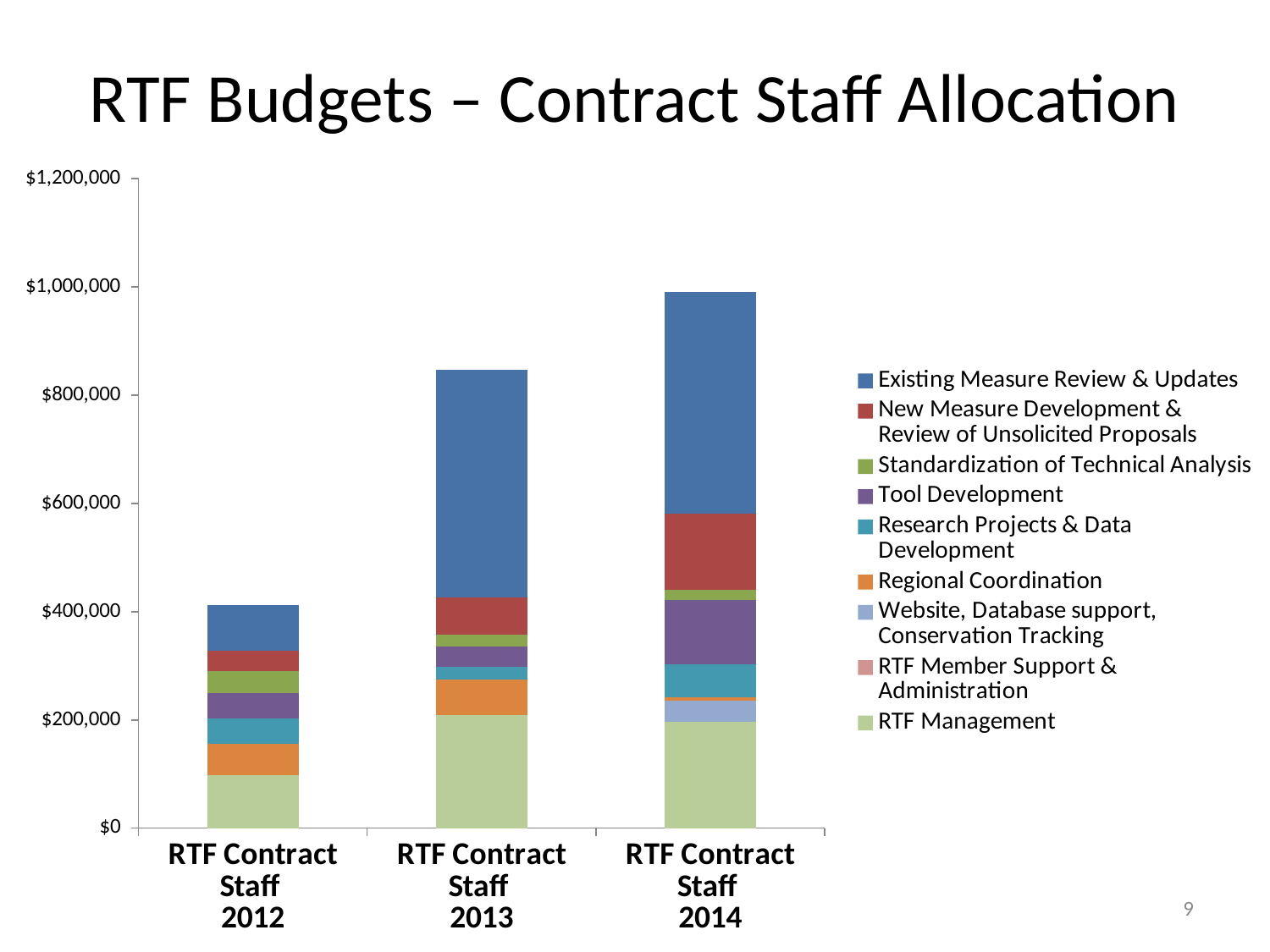
What kind of chart is shown on the slide? Stacked bar chart Which category has the lowest total bar? RTF Contract Staff 2012 Which has a larger total, RTF Contract Staff 2012 or RTF Contract Staff 2013? RTF Contract Staff 2013 Is the total for RTF Contract Staff 2014 greater or less than $800,000? greater Which series forms the bottom segment of each stacked bar? RTF Management What is the title of the slide? RTF Budgets – Contract Staff Allocation How many series does the legend list? 9 Is the total for RTF Contract Staff 2012 greater or less than $600,000? less Is the total for RTF Contract Staff 2013 greater or less than $600,000? greater How many bars (categories) are plotted on the chart? 3 Do the total bar heights rise or fall from 2012 to 2014? rise Which category has the highest total bar? RTF Contract Staff 2014